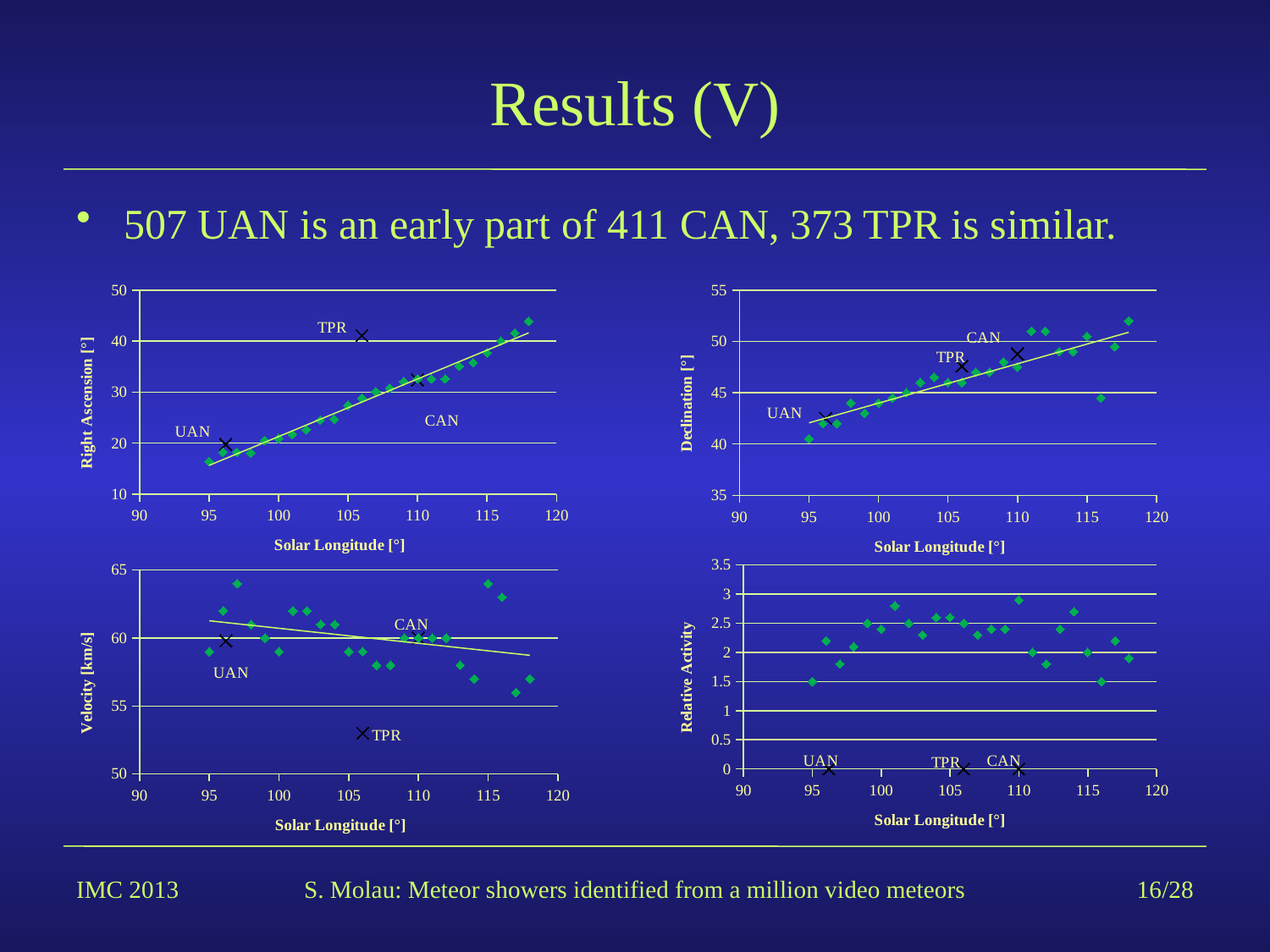
In the Velocity chart, is the value for the TPR marker greater or less than 55? less In the Right Ascension chart, do the green data points rise or fall as Solar Longitude increases? rise What is the x-axis title shared by all four charts? Solar Longitude [°] What kind of chart is the Right Ascension chart on the slide? scatter chart In the Velocity chart, does the fitted trend line rise or fall as Solar Longitude increases? fall In the Declination chart, do the green data points rise or fall as Solar Longitude increases? rise In the Right Ascension chart, is the value for the CAN marker greater or less than 30? greater How many charts are shown on the slide? 4 In the Declination chart, which of the three labelled markers (UAN, TPR, CAN) has the lowest declination? UAN In the Declination chart, is the value for the CAN marker greater or less than 50? less What is the y-axis title of the bottom-left chart? Velocity [km/s]